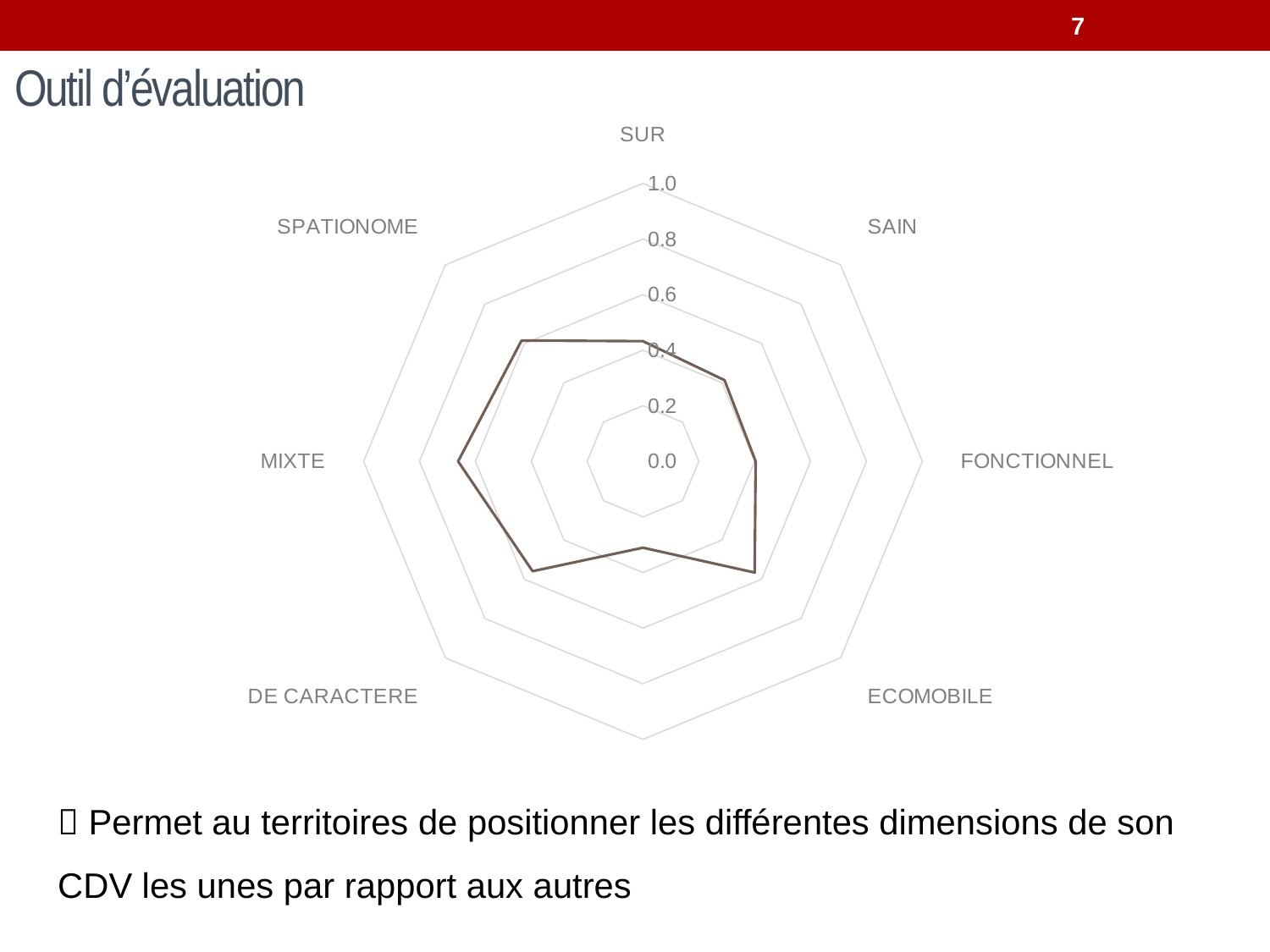
Is the value for ECOMOBILE greater or less than 0.4? greater Is the value for DE CARACTERE greater or less than 0.8? less Which has the larger value, MIXTE or FONCTIONNEL? MIXTE How many data series are plotted on the radar chart? 1 Is the value for FONCTIONNEL greater or less than 0.6? less Which has the larger value, SPATIONOME or SUR? SPATIONOME What kind of chart is shown on the slide? Radar chart How many axes (categories) does the radar chart have? 8 Which has the larger value, ECOMOBILE or SAIN? ECOMOBILE What is the maximum value shown on the radar chart's scale? 1.0